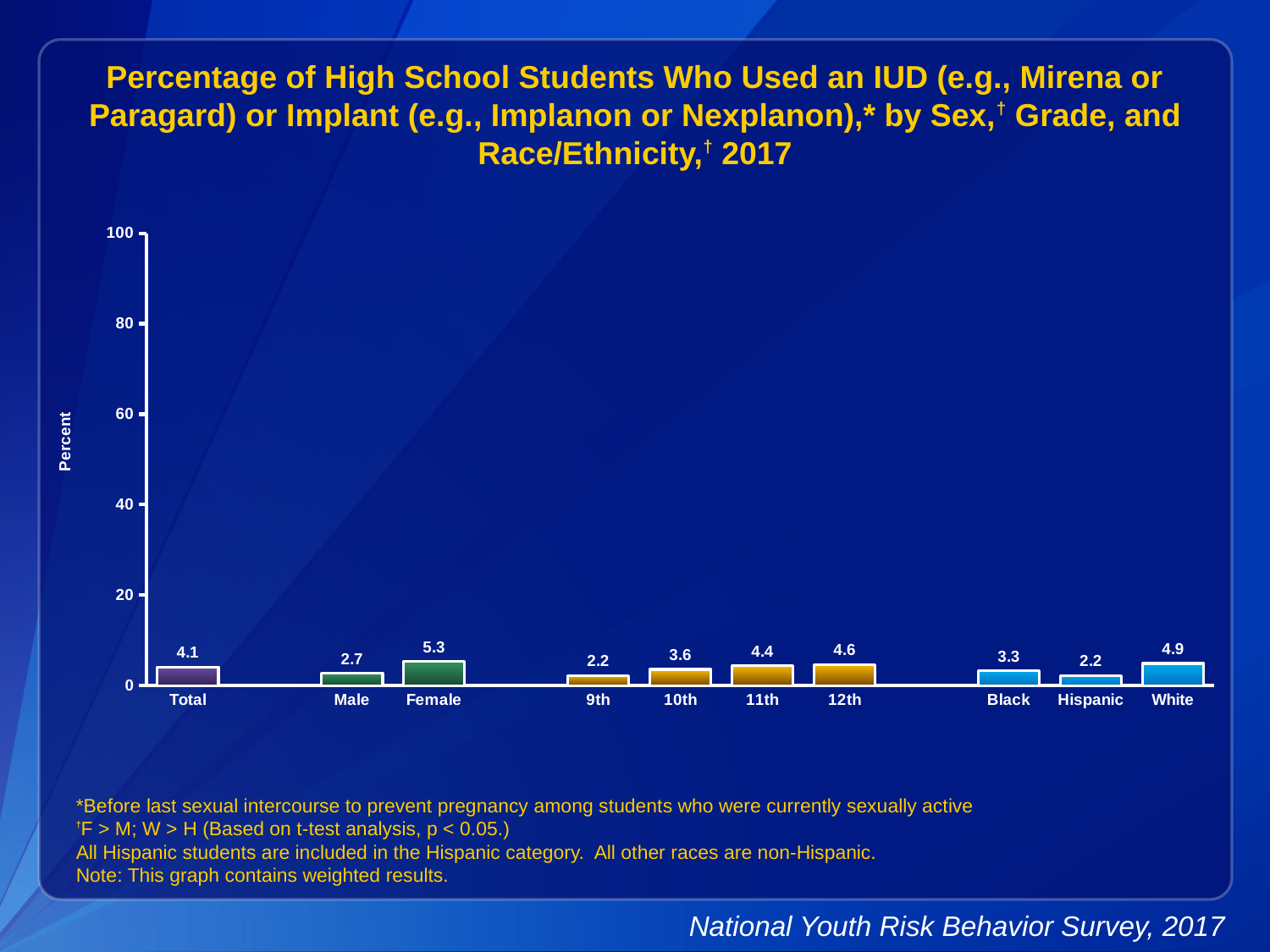
What is the value for Black students? 3.3 Which grade has the lowest value? 9th What is the value for Female? 5.3 What is the value for Total? 4.1 Which is larger, the value for 12th grade or the value for 10th grade? 12th Do the values rise or fall from 9th grade to 12th grade? rise How many categories are shown on the x axis? 10 What is the difference between the Female and Male values? 2.6 What kind of chart is this? bar chart What is the difference between the White and Hispanic values? 2.7 Which category has the highest value? Female What is the value for 9th grade? 2.2